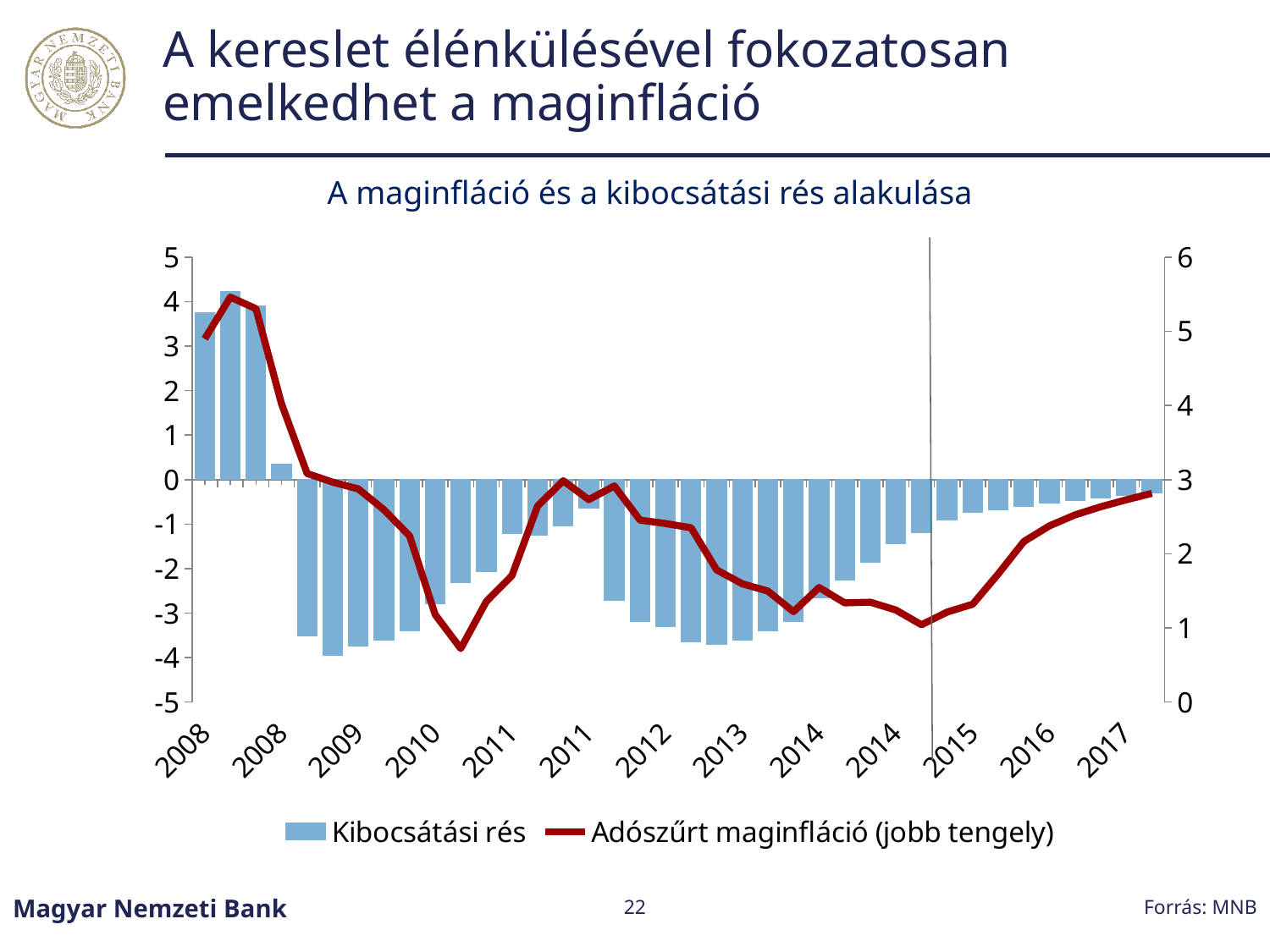
What is the title of the chart? A maginfláció és a kibocsátási rés alakulása In which year is the highest Kibocsátási rés bar? 2008 Is the lowest Kibocsátási rés bar, in 2009, greater or less than -3 on the left axis? less Is the value of the first Kibocsátási rés bar in 2008 greater or less than 3 on the left axis? greater Which series does the legend say is plotted on the right axis? Adószűrt maginfláció (jobb tengely) How many series does the legend list? 2 In which year is the lowest Kibocsátási rés bar? 2009 Is the lowest point of the Adószűrt maginfláció line, around 2010, greater or less than 1 on the right axis? less What kind of chart is shown on the slide? A combined bar and line chart Does the Adószűrt maginfláció line rise or fall between 2008 and 2010? fall Does the Adószűrt maginfláció line rise or fall between 2015 and 2017? rise